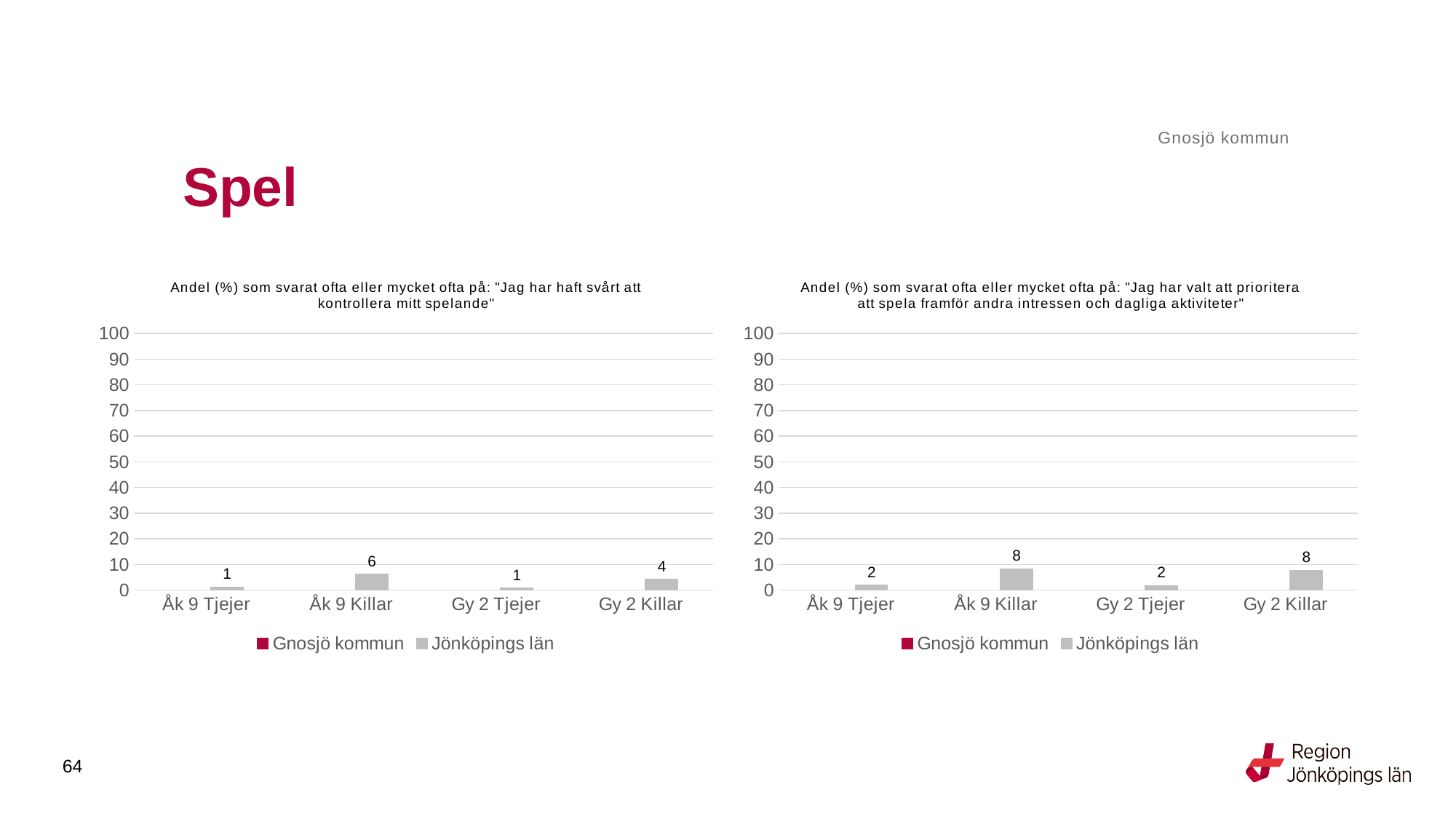
In the left chart ("Jag har haft svårt att kontrollera mitt spelande"), which category has the highest Jönköpings län value? Åk 9 Killar In the right chart ("Jag har valt att prioritera att spela framför andra intressen..."), what is the difference between the Jönköpings län values for Åk 9 Killar and Åk 9 Tjejer? 6 How many categories are shown on the x axis of the right chart ("Jag har valt att prioritera att spela framför andra intressen...")? 4 In the left chart ("Jag har haft svårt att kontrollera mitt spelande"), what is the difference between the Jönköpings län values for Åk 9 Killar and Gy 2 Killar? 2 In the right chart ("Jag har valt att prioritera att spela framför andra intressen..."), what is the value for Jönköpings län for Åk 9 Tjejer? 2 In the right chart ("Jag har valt att prioritera att spela framför andra intressen..."), what is the value for Jönköpings län for Gy 2 Killar? 8 What kind of chart is the right chart ("Jag har valt att prioritera att spela framför andra intressen...")? Bar chart In the left chart ("Jag har haft svårt att kontrollera mitt spelande"), what is the value for Jönköpings län for Gy 2 Killar? 4 How many series does the legend of the left chart ("Jag har haft svårt att kontrollera mitt spelande") list? 2 In the left chart ("Jag har haft svårt att kontrollera mitt spelande"), is the Jönköpings län value for Åk 9 Killar greater or less than 10? less In the right chart ("Jag har valt att prioritera att spela framför andra intressen..."), which is larger for Jönköpings län: Gy 2 Tjejer or Gy 2 Killar? Gy 2 Killar In the left chart ("Jag har haft svårt att kontrollera mitt spelande"), what is the value for Jönköpings län for Åk 9 Killar? 6